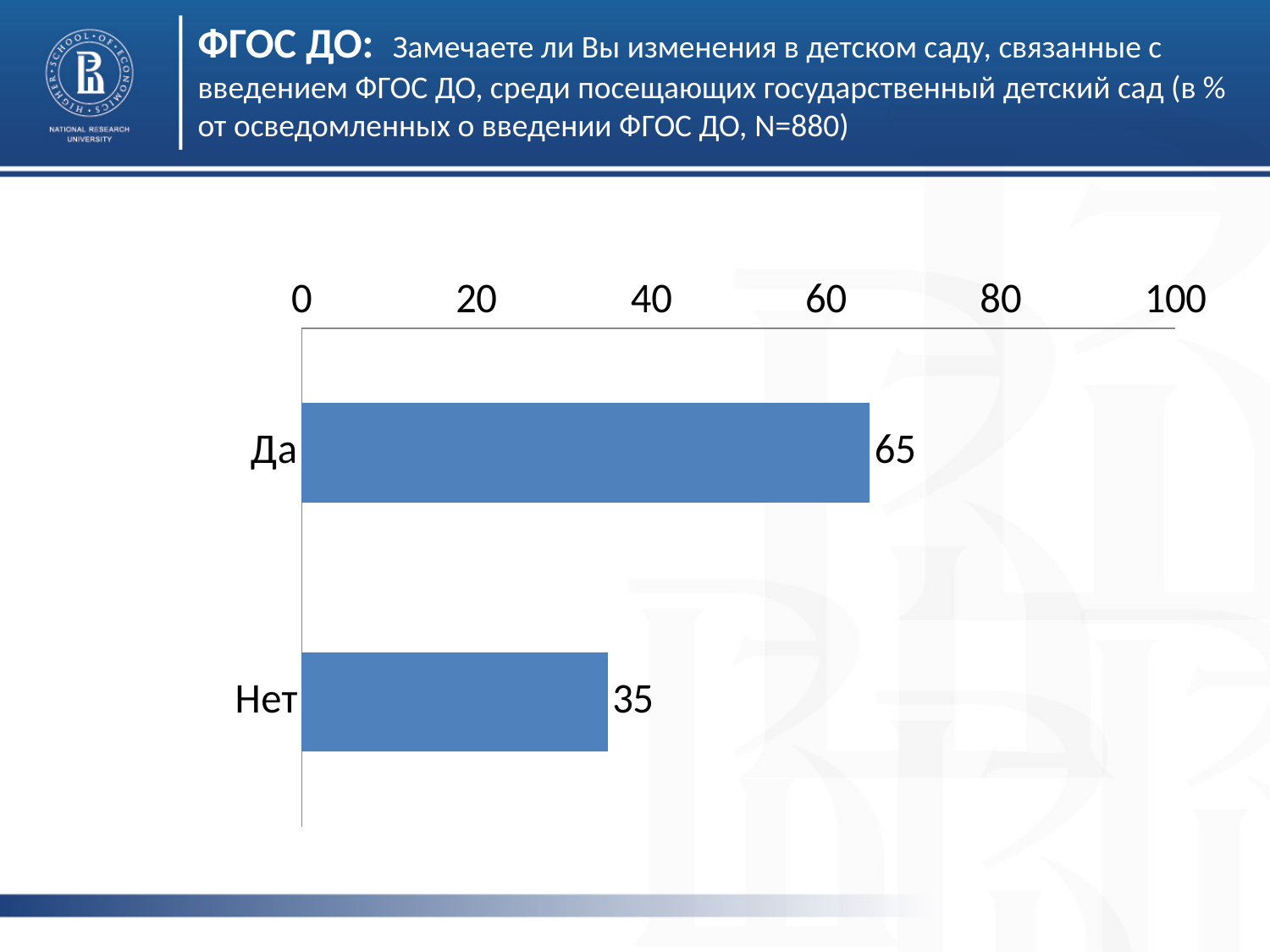
What is the value for "Нет"? 35 What is the difference between the values for "Да" and "Нет"? 30 Is the value for "Нет" greater or less than 40? less Which category has the highest value? Да What is the maximum value shown on the chart's axis? 100 What kind of chart is shown on the slide? bar chart Is the value for "Да" greater or less than 60? greater What is the total of the two values shown in the chart? 100 Which category has the lowest value? Нет What is the value for "Да"? 65 Which is larger, the value for "Да" or the value for "Нет"? Да How many categories are shown in the chart? 2